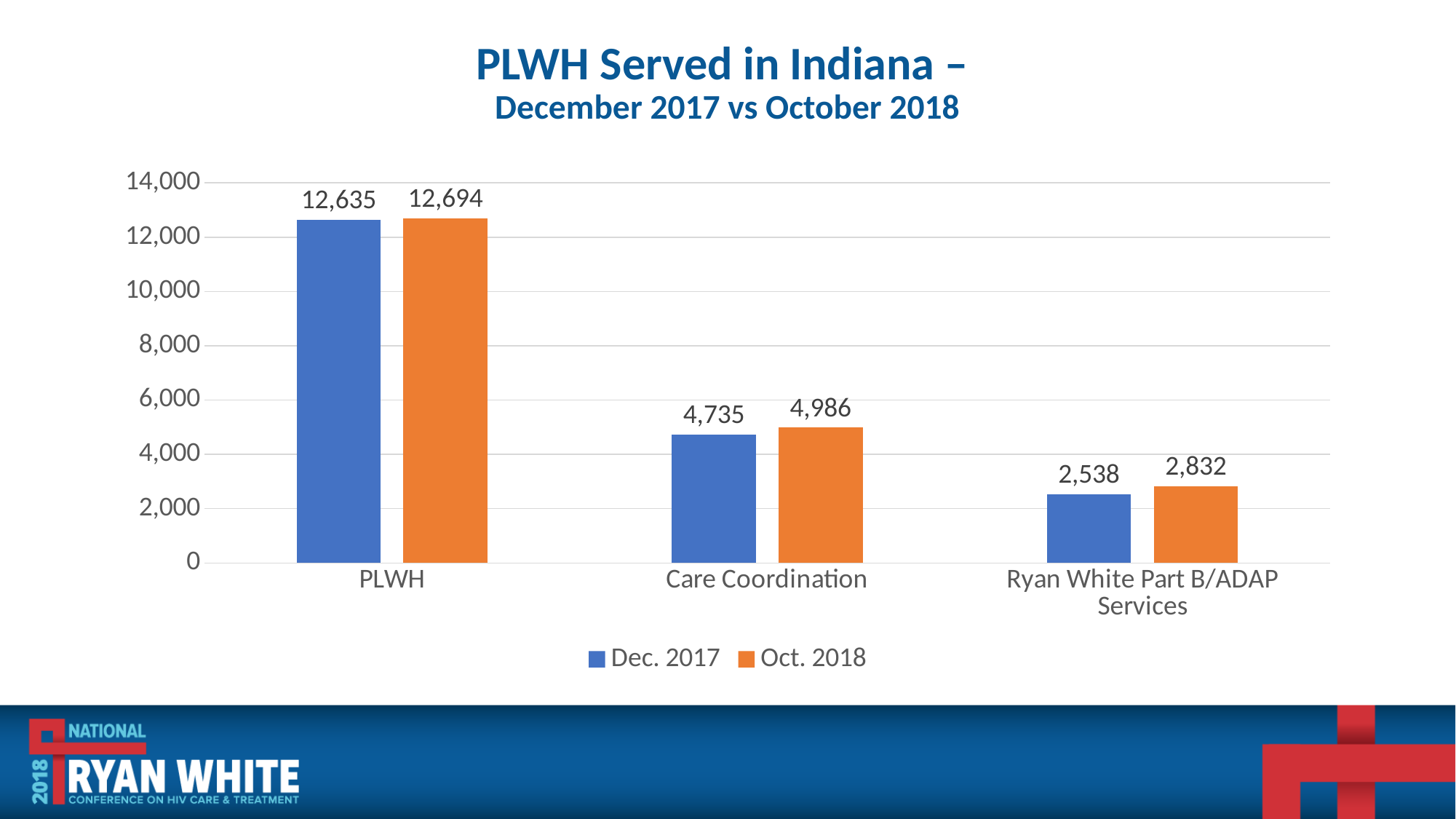
Which category has the lowest Dec. 2017 value? Ryan White Part B/ADAP Services What is the Oct. 2018 value for Care Coordination? 4,986 Which is larger for Care Coordination: the Dec. 2017 value or the Oct. 2018 value? Oct. 2018 What is the difference between the Oct. 2018 and Dec. 2017 values for Care Coordination? 251 How many series does the legend list? 2 What kind of chart is shown on the slide? bar chart What is the Dec. 2017 value for Ryan White Part B/ADAP Services? 2,538 How many categories are shown on the x axis? 3 What is the Dec. 2017 value for PLWH? 12,635 Is the Oct. 2018 value for PLWH greater or less than 12,000? greater What is the difference between the Oct. 2018 and Dec. 2017 values for Ryan White Part B/ADAP Services? 294 Which category has the highest Oct. 2018 value? PLWH